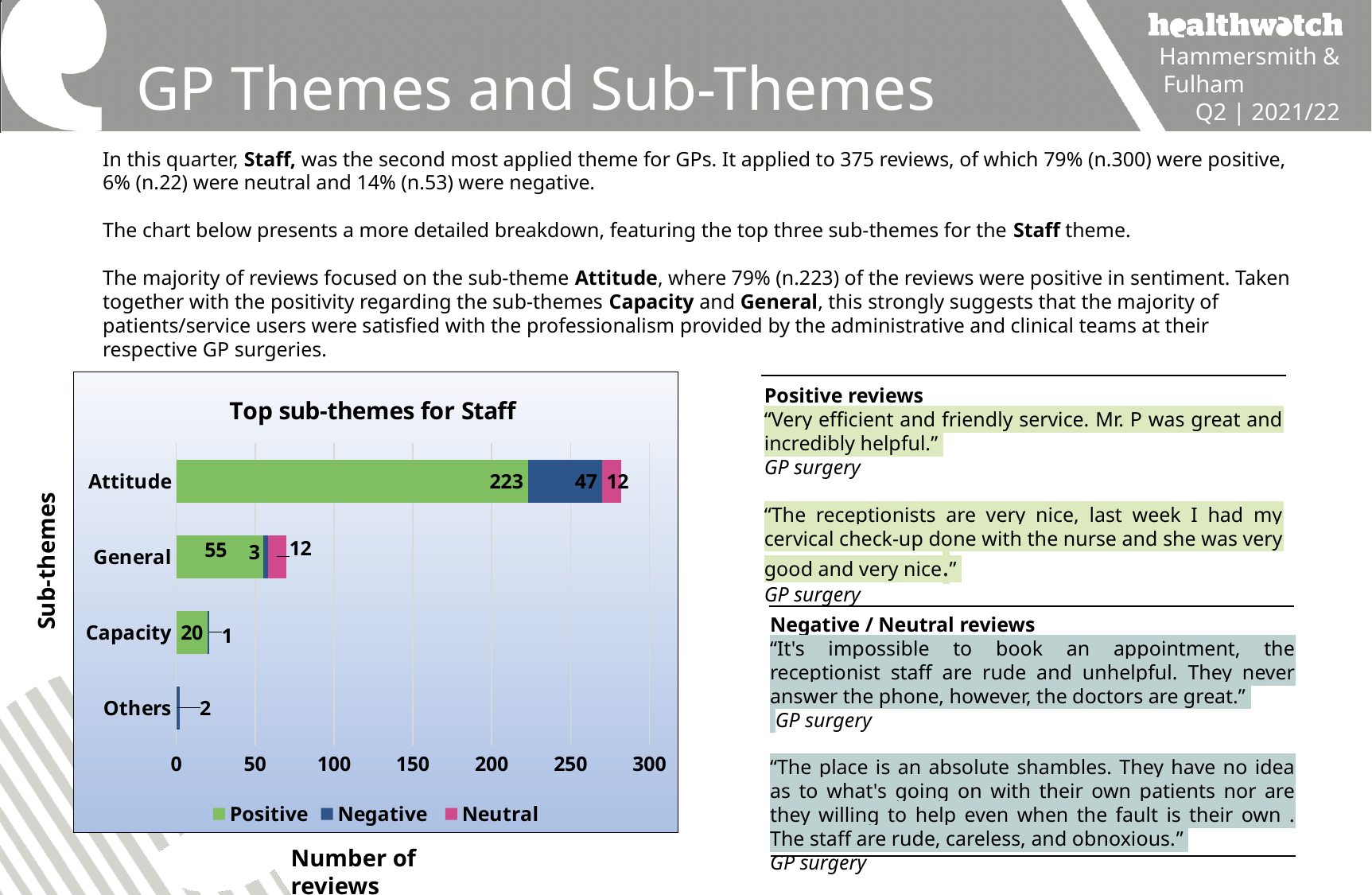
What is the total number of reviews in the stacked bar for Attitude? 282 How many sub-themes are listed on the y axis of the chart? 4 Which sub-theme has the highest number of Positive reviews? Attitude How many Negative reviews are shown for the Attitude sub-theme? 47 What kind of chart is shown on the slide? Bar chart How many Positive reviews are shown for the General sub-theme? 55 What is the title of the chart? Top sub-themes for Staff For the Attitude sub-theme, which is larger: the Negative reviews or the Neutral reviews? Negative How many series does the chart legend list? 3 How many Positive reviews are shown for the Attitude sub-theme? 223 How many Neutral reviews are shown for the General sub-theme? 12 What is the difference between the Positive reviews for Attitude and the Positive reviews for General? 168